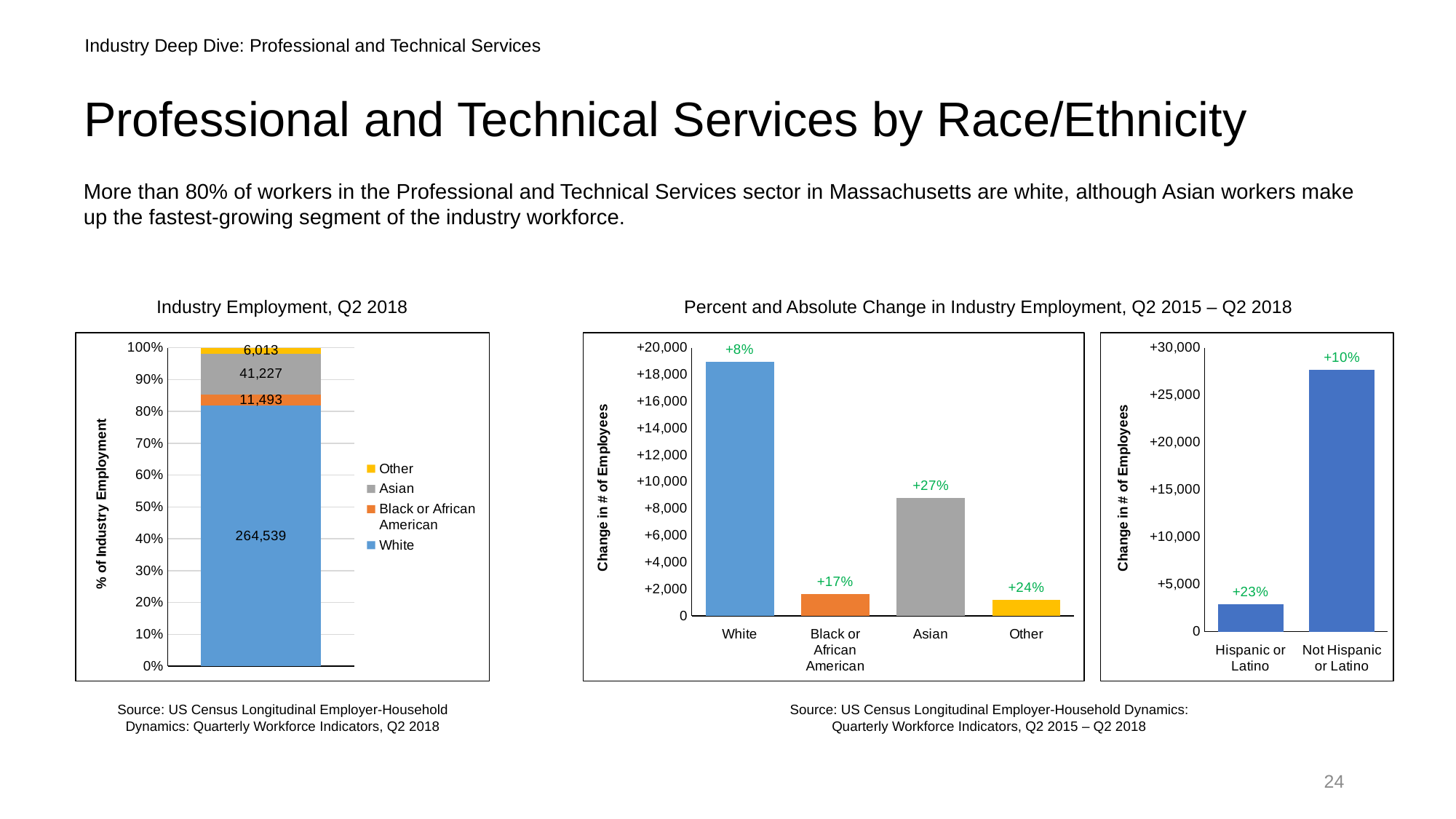
In the middle chart showing change in industry employment by race, how many categories are shown on the x axis? 4 In the middle chart showing change in industry employment by race, is the value for White greater or less than 16,000? greater In the middle chart showing change in industry employment by race, is the value for Black or African American greater or less than 2,000? less In the 'Industry Employment, Q2 2018' chart, what is the difference between the Asian and Black or African American values? 29,734 In the rightmost chart showing change in industry employment by Hispanic or Latino status, what is the percent change label for Hispanic or Latino? +23% In the 'Industry Employment, Q2 2018' chart, what is the total of all four segments of the stacked bar? 323,272 How many series does the legend of the 'Industry Employment, Q2 2018' chart list? 4 In the middle chart showing change in industry employment by race, which category has the largest change in number of employees? White In the 'Industry Employment, Q2 2018' chart, what is the data label for the Asian segment? 41,227 In the 'Industry Employment, Q2 2018' chart, what is the data label for the White segment? 264,539 In the middle chart showing change in industry employment by race, what is the percent change label for Asian? +27% In the rightmost chart showing change in industry employment by Hispanic or Latino status, is the value for Not Hispanic or Latino greater or less than 25,000? greater